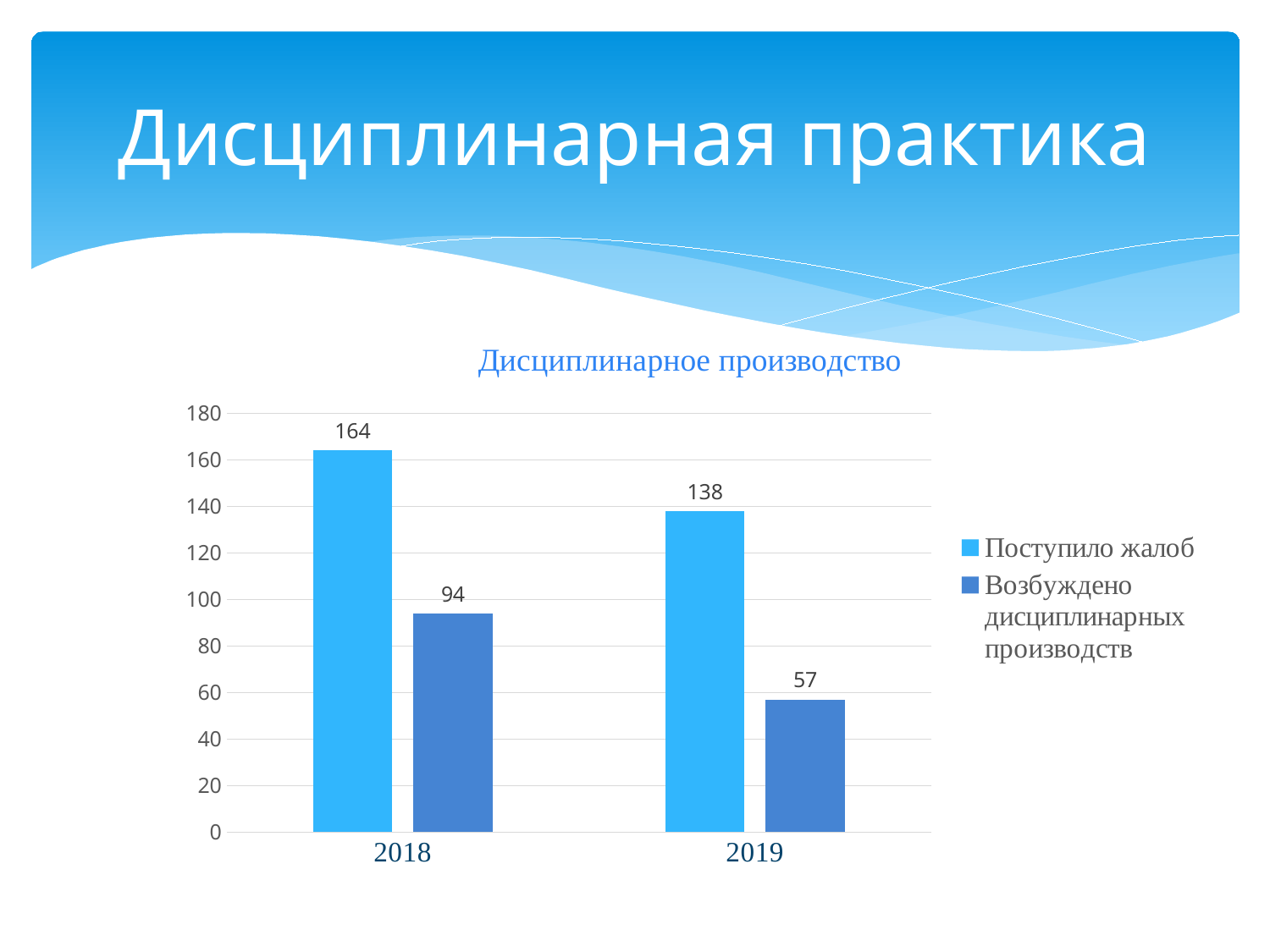
What is the difference between "Поступило жалоб" in 2018 and in 2019? 26 What kind of chart is shown on the slide? Bar chart How many series does the legend list? 2 Which year has the lowest value for "Возбуждено дисциплинарных производств"? 2019 Which is larger: "Возбуждено дисциплинарных производств" in 2018 or "Поступило жалоб" in 2019? Поступило жалоб in 2019 What is the value for "Возбуждено дисциплинарных производств" in 2019? 57 What is the title of the chart? Дисциплинарное производство Which year has the highest value for "Поступило жалоб"? 2018 What is the value for "Поступило жалоб" in 2019? 138 What is the value for "Возбуждено дисциплинарных производств" in 2018? 94 What is the value for "Поступило жалоб" in 2018? 164 What is the difference between "Поступило жалоб" and "Возбуждено дисциплинарных производств" in 2019? 81